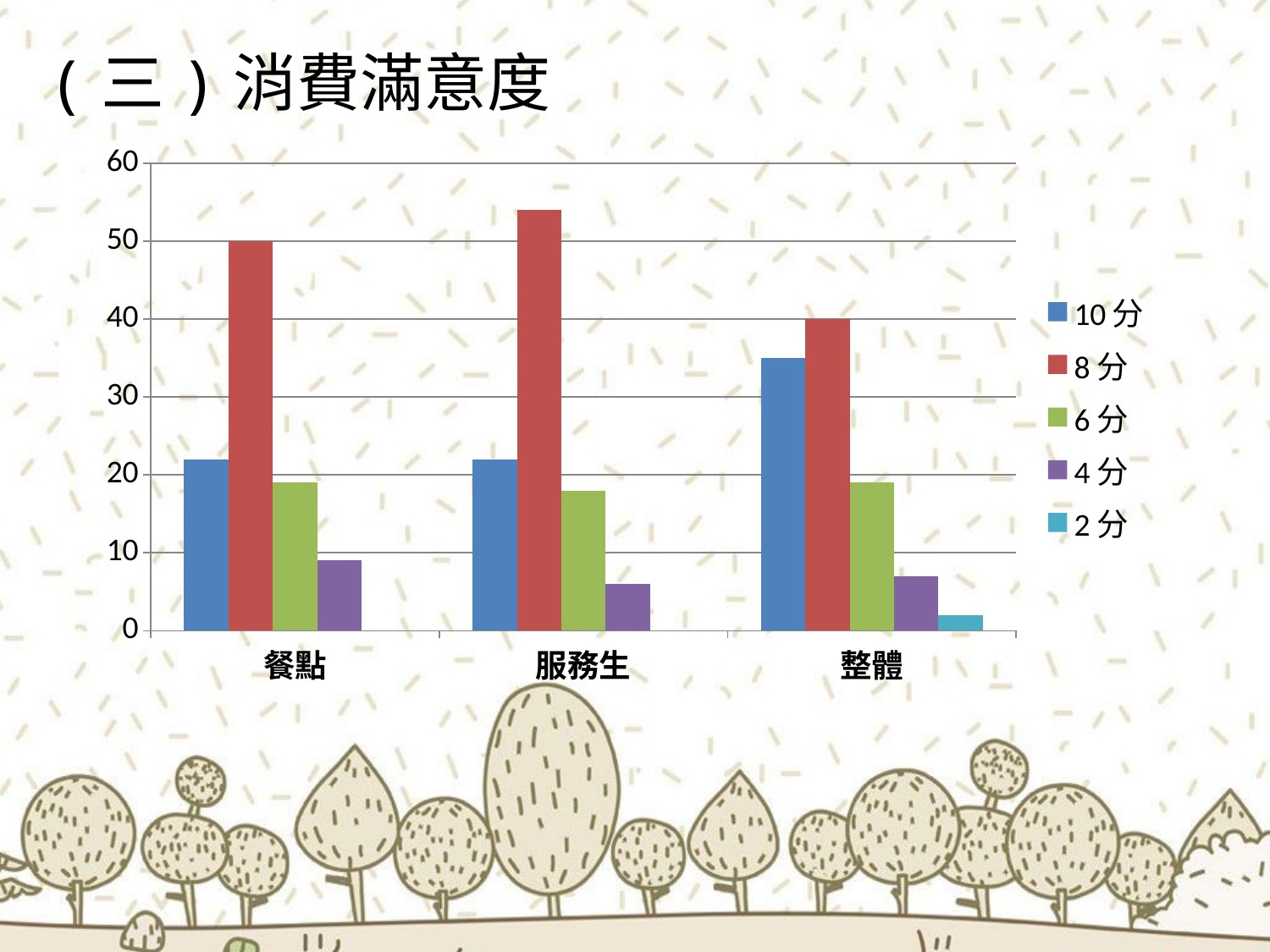
What is the value of the 8 分 bar for 整體? 40 Is the value of the 4 分 bar for 服務生 greater or less than 10? less What kind of chart is shown on the slide? bar chart Which category has the highest 8 分 bar? 服務生 How many series does the legend list? 5 What is the title of the slide? （三）消費滿意度 Which category has the highest 10 分 bar? 整體 How many categories are shown on the x axis? 3 In the 餐點 category, which is larger, the 10 分 bar or the 6 分 bar? 10 分 What is the value of the 8 分 bar for 餐點? 50 Which series has the lowest bar in the 整體 category? 2 分 Is the value of the 10 分 bar for 整體 greater or less than 30? greater